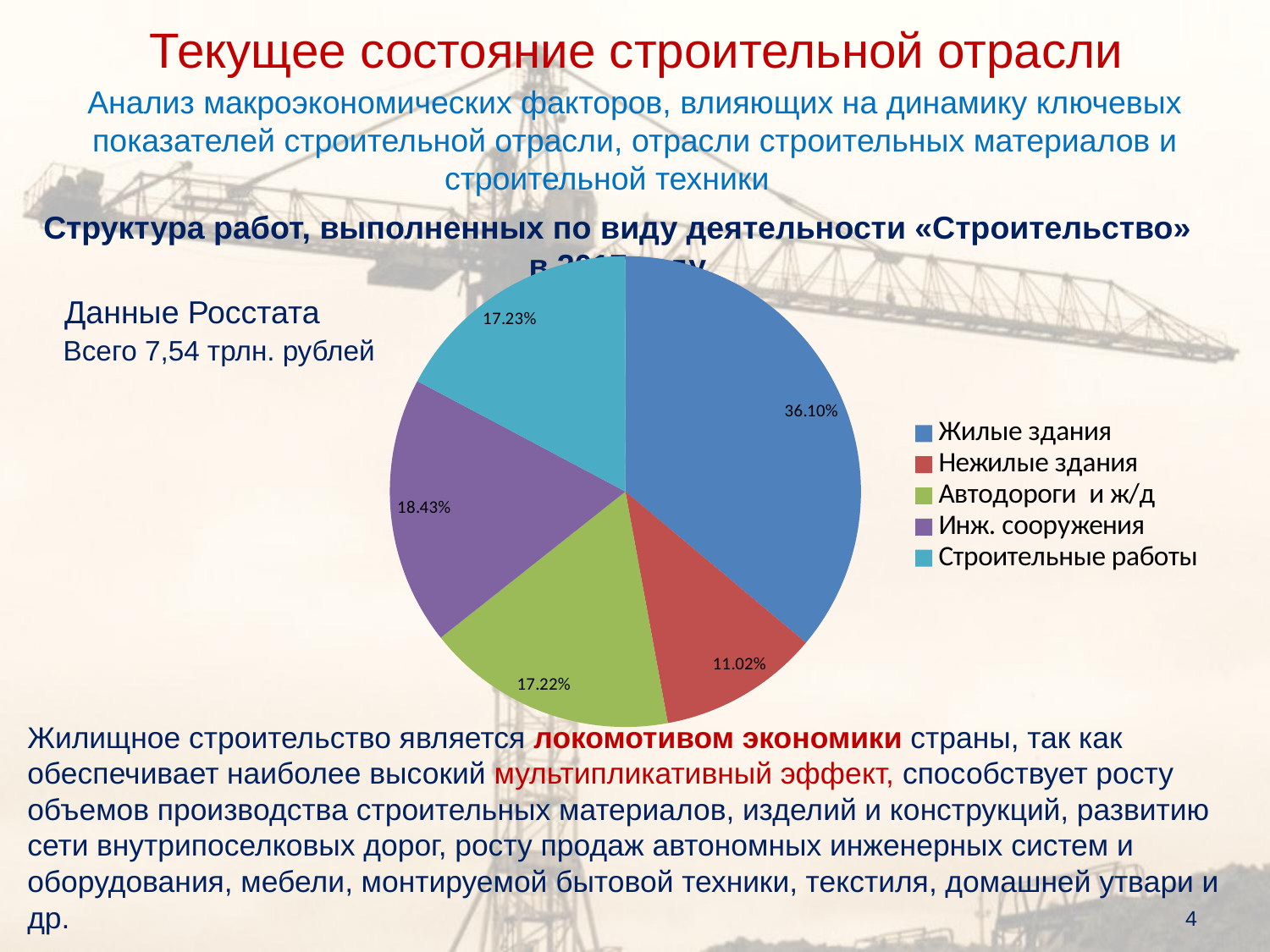
How many categories does the pie chart have? 5 Which category has the smallest share of the pie? Нежилые здания Which is larger, the share of Инж. сооружения or the share of Нежилые здания? Инж. сооружения What colour is the slice for Жилые здания? Blue Which category has the largest share of the pie? Жилые здания What is the difference between the shares of Жилые здания and Нежилые здания? 25.08% What is the share for Строительные работы? 17.23% What is the share for Автодороги и ж/д? 17.22% What is the share for Нежилые здания? 11.02% What is the share for Жилые здания? 36.10% What is the share for Инж. сооружения? 18.43% What kind of chart is shown on the slide? Pie chart